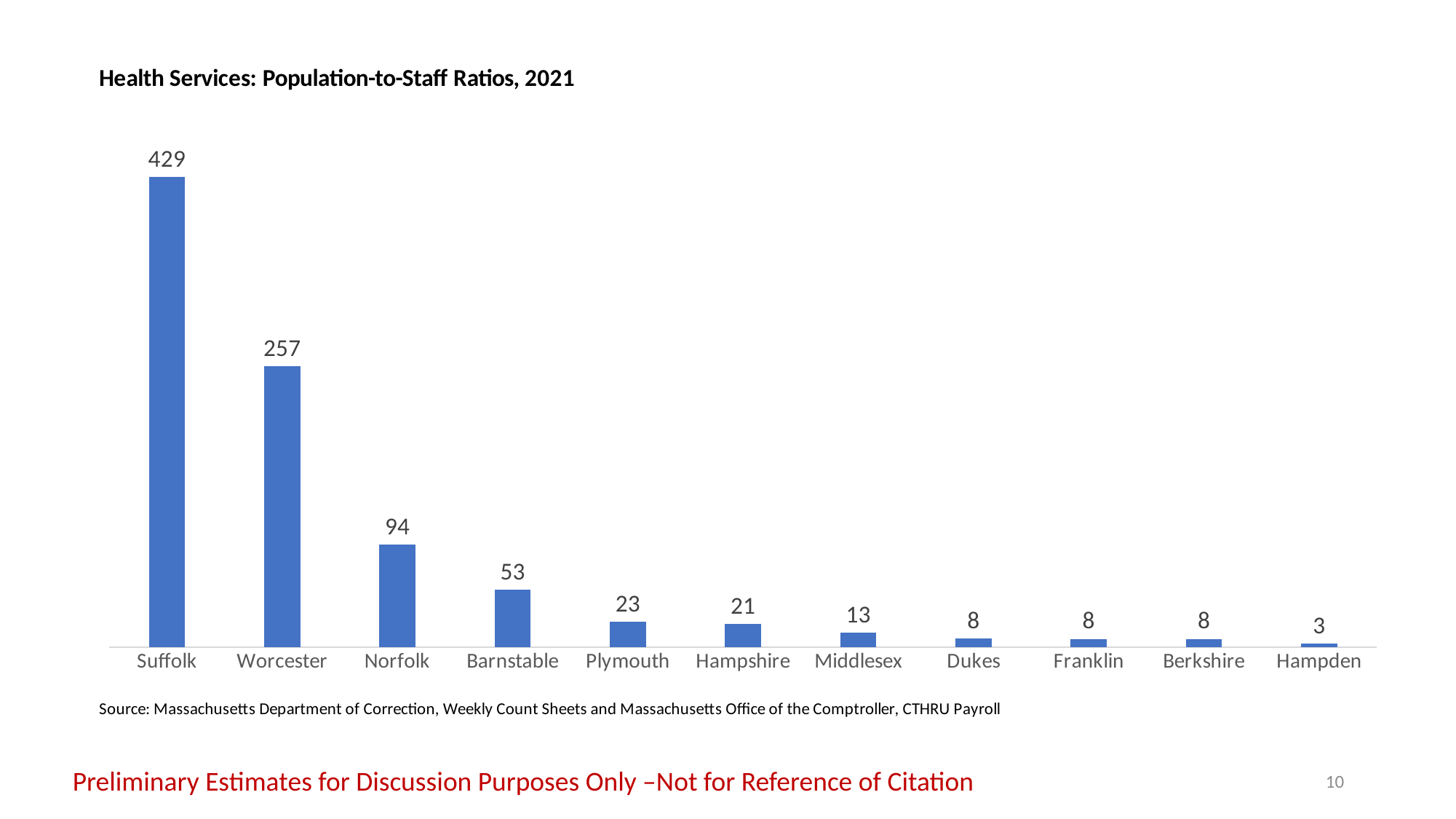
Do the values rise or fall moving from left to right across the chart? Fall Which county has the lowest population-to-staff ratio? Hampden Which has a larger value, Plymouth or Hampshire? Plymouth What kind of chart is shown on the slide? Bar chart How many counties are shown on the chart? 11 What is the difference between the values for Norfolk and Barnstable? 41 What is the value shown for Middlesex? 13 What is the population-to-staff ratio for Suffolk? 429 What is the difference between the values for Suffolk and Worcester? 172 Which county has the highest population-to-staff ratio? Suffolk What is the value shown for Norfolk? 94 What is the title of the chart? Health Services: Population-to-Staff Ratios, 2021